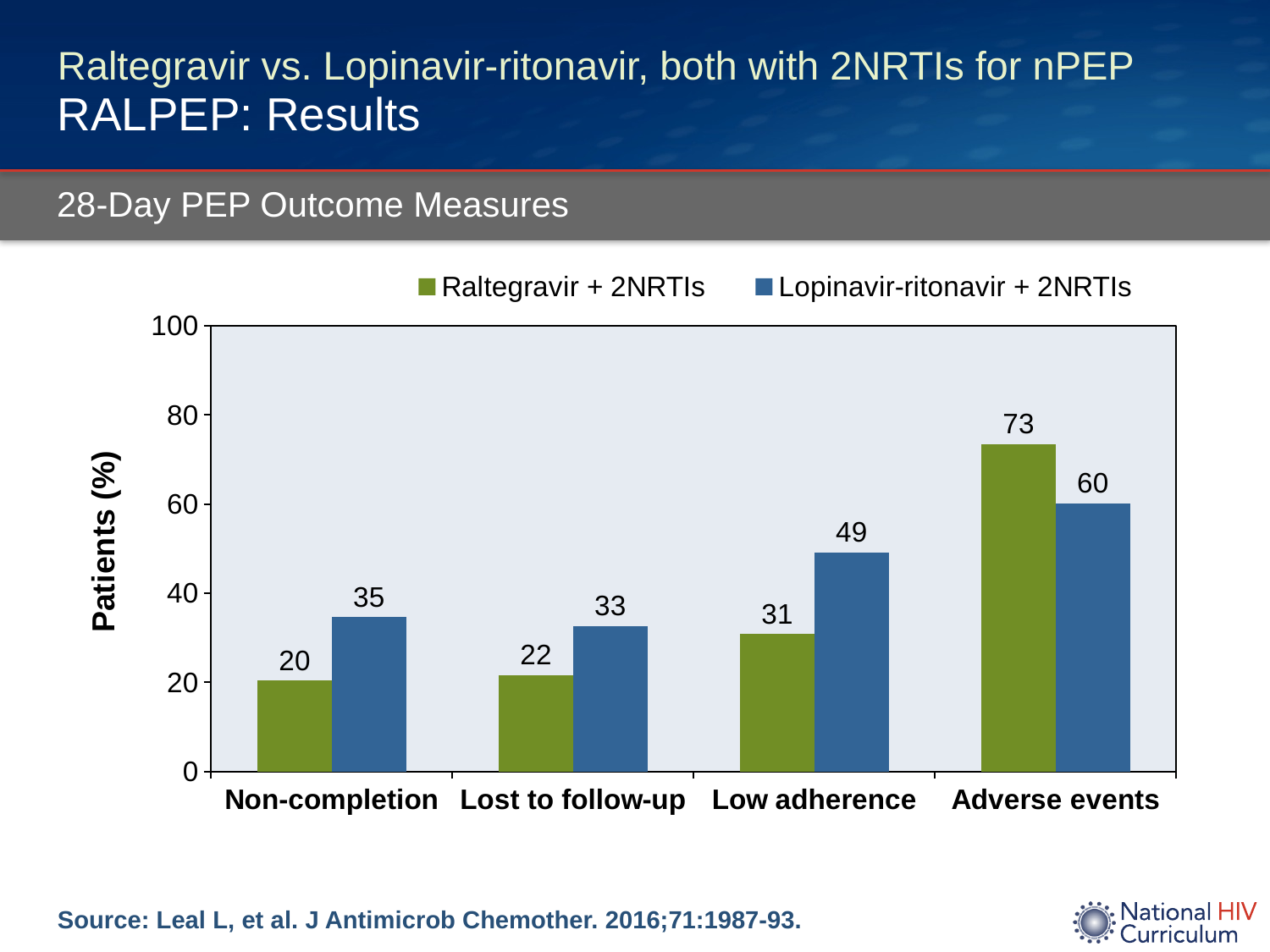
How many outcome measure categories are shown on the x axis? 4 What percentage of patients in the Raltegravir + 2NRTIs group had non-completion? 20 For lost to follow-up, which group has the larger value? Lopinavir-ritonavir + 2NRTIs Which outcome measure has the highest value for the Raltegravir + 2NRTIs group? Adverse events What is the value for adverse events in the Lopinavir-ritonavir + 2NRTIs group? 60 What percentage of patients in the Lopinavir-ritonavir + 2NRTIs group had low adherence? 49 What is the difference between the Lopinavir-ritonavir + 2NRTIs and Raltegravir + 2NRTIs values for low adherence? 18 What type of chart is shown on the slide? Bar chart What is the difference between the two groups for adverse events? 13 Which outcome measure has the lowest value for the Lopinavir-ritonavir + 2NRTIs group? Lost to follow-up How many series does the legend list? 2 Is the value for adverse events in the Raltegravir + 2NRTIs group greater or less than 60? greater